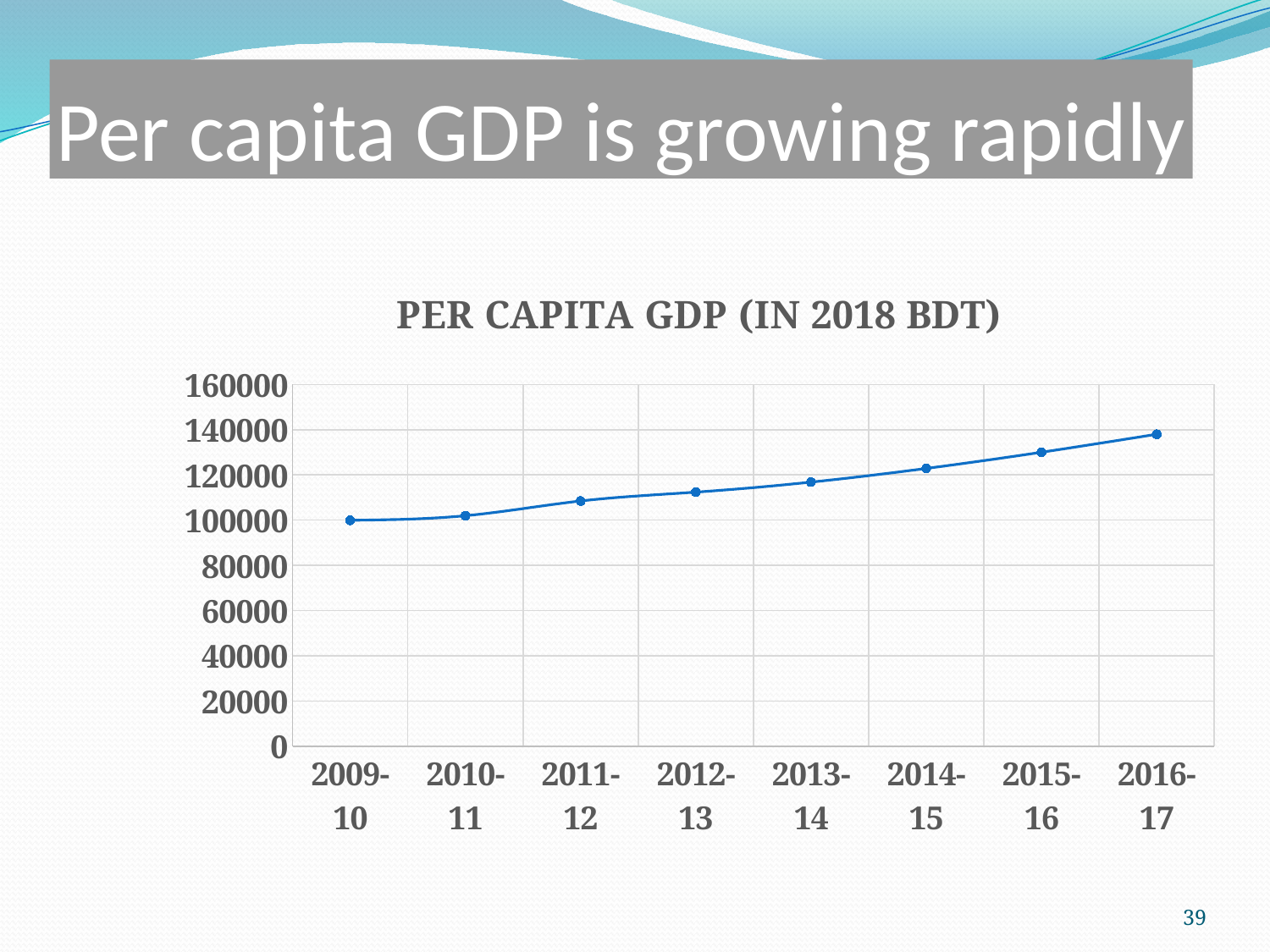
How many fiscal years are plotted on the x axis? 8 Is the value for 2011-12 greater or less than 120000? less Does per capita GDP rise or fall from 2009-10 to 2016-17? rise Is the value for 2016-17 greater or less than 120000? greater What is the title of the chart? PER CAPITA GDP (IN 2018 BDT) Is the value for 2015-16 greater or less than 120000? greater Which is larger, the value for 2013-14 or the value for 2010-11? 2013-14 Which fiscal year has the highest per capita GDP? 2016-17 What type of chart is shown on the slide? line chart Which fiscal year has the lowest per capita GDP? 2009-10